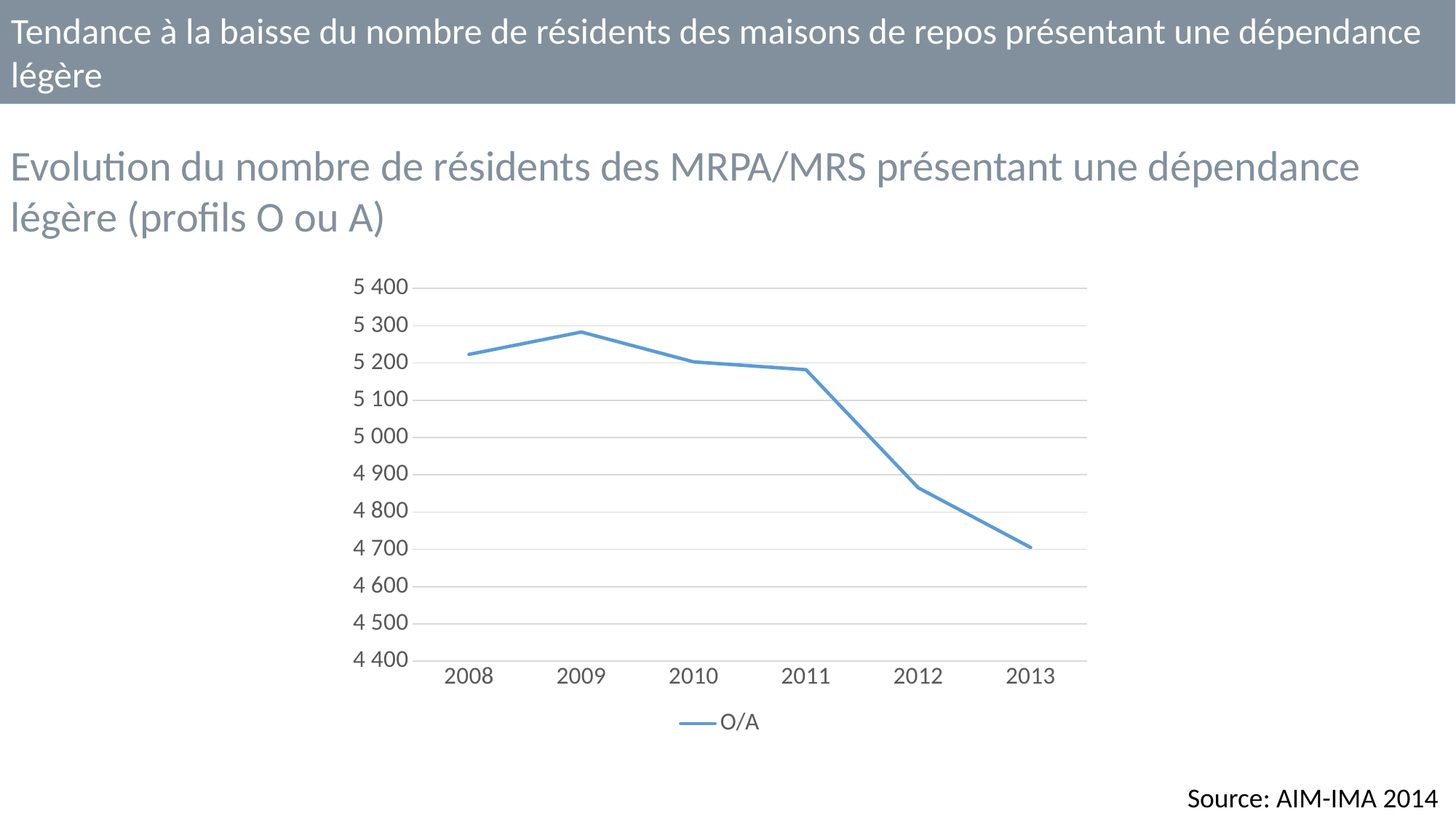
Is the value for 2009 greater or less than 5 200? greater In which year is the number of O/A residents lowest? 2013 Overall, do the values rise or fall from 2009 to 2013? fall How many years are plotted on the x axis? 6 Is the value for 2013 greater or less than 4 800? less What kind of chart is shown on the slide? line chart Which year has the larger value, 2008 or 2012? 2008 What is the name of the series shown in the legend? O/A Is the value for 2010 greater or less than 5 100? greater How many series does the legend list? 1 In which year is the number of O/A residents highest? 2009